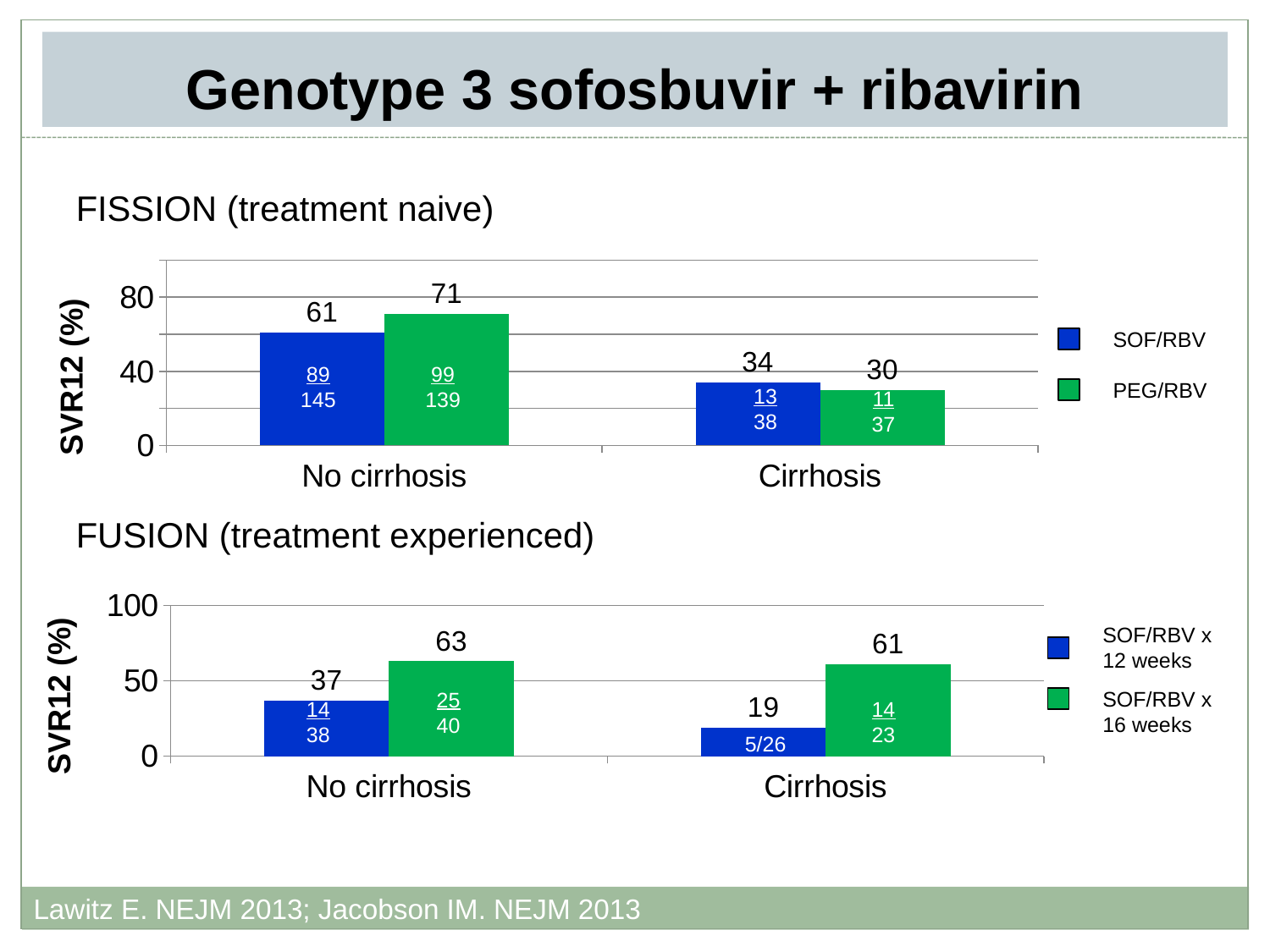
In the FUSION (treatment experienced) chart, which bar has the lowest SVR12 (%)? SOF/RBV x 12 weeks, Cirrhosis In the FISSION (treatment naive) chart, what is the SVR12 (%) for PEG/RBV in the Cirrhosis group? 30 In the FISSION (treatment naive) chart, which bar has the highest SVR12 (%)? PEG/RBV, No cirrhosis In the FUSION (treatment experienced) chart, how many categories are shown on the x axis? 2 In the FISSION (treatment naive) chart, what is the SVR12 (%) for SOF/RBV in the No cirrhosis group? 61 In the FUSION (treatment experienced) chart, what is the SVR12 (%) for SOF/RBV x 16 weeks in the Cirrhosis group? 61 In the FISSION (treatment naive) chart, what is the difference in SVR12 (%) between PEG/RBV and SOF/RBV in the No cirrhosis group? 10 In the FUSION (treatment experienced) chart, what is the SVR12 (%) for SOF/RBV x 12 weeks in the No cirrhosis group? 37 In the FISSION (treatment naive) chart, how many series does the legend list? 2 What kind of chart is the FUSION (treatment experienced) chart? Bar chart In the FUSION (treatment experienced) chart, what is the difference in SVR12 (%) between SOF/RBV x 16 weeks and SOF/RBV x 12 weeks in the Cirrhosis group? 42 In the FISSION (treatment naive) chart, which is larger in the Cirrhosis group: SOF/RBV or PEG/RBV? SOF/RBV